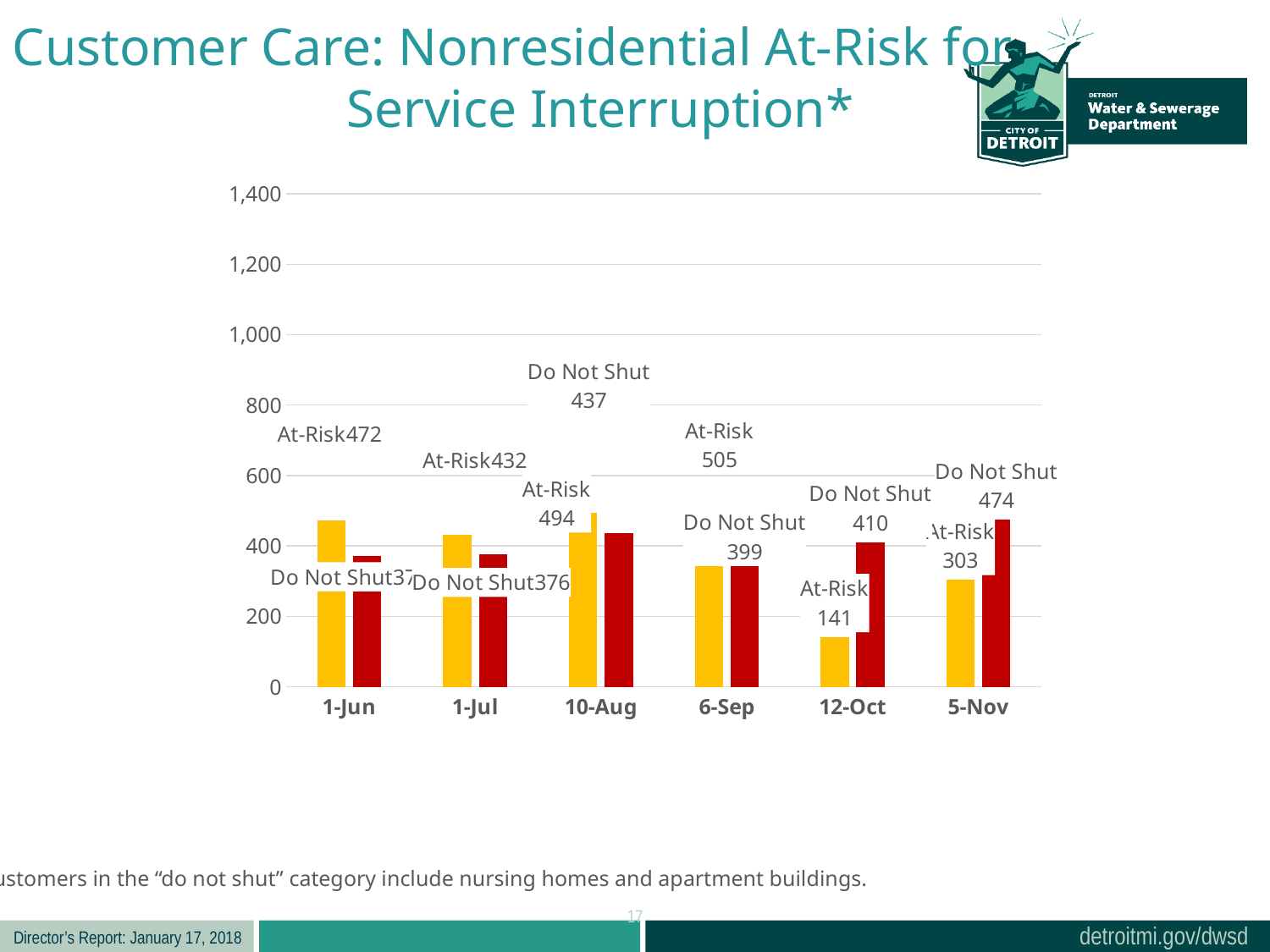
For 12-Oct, which is larger: At-Risk or Do Not Shut? Do Not Shut What is the At-Risk value for 12-Oct? 141 How many dates are shown on the x axis? 6 What is the Do Not Shut value for 5-Nov? 474 Which date has the lowest At-Risk value? 12-Oct Which date has the highest Do Not Shut value? 5-Nov Is the Do Not Shut value for 1-Jun greater or less than 400? less What kind of chart is shown on the slide? bar chart What is the Do Not Shut value for 1-Jul? 376 What is the At-Risk value for 1-Jun? 472 For 5-Nov, what is the difference between the Do Not Shut value and the At-Risk value? 171 For 10-Aug, how much larger is the At-Risk value than the Do Not Shut value? 57